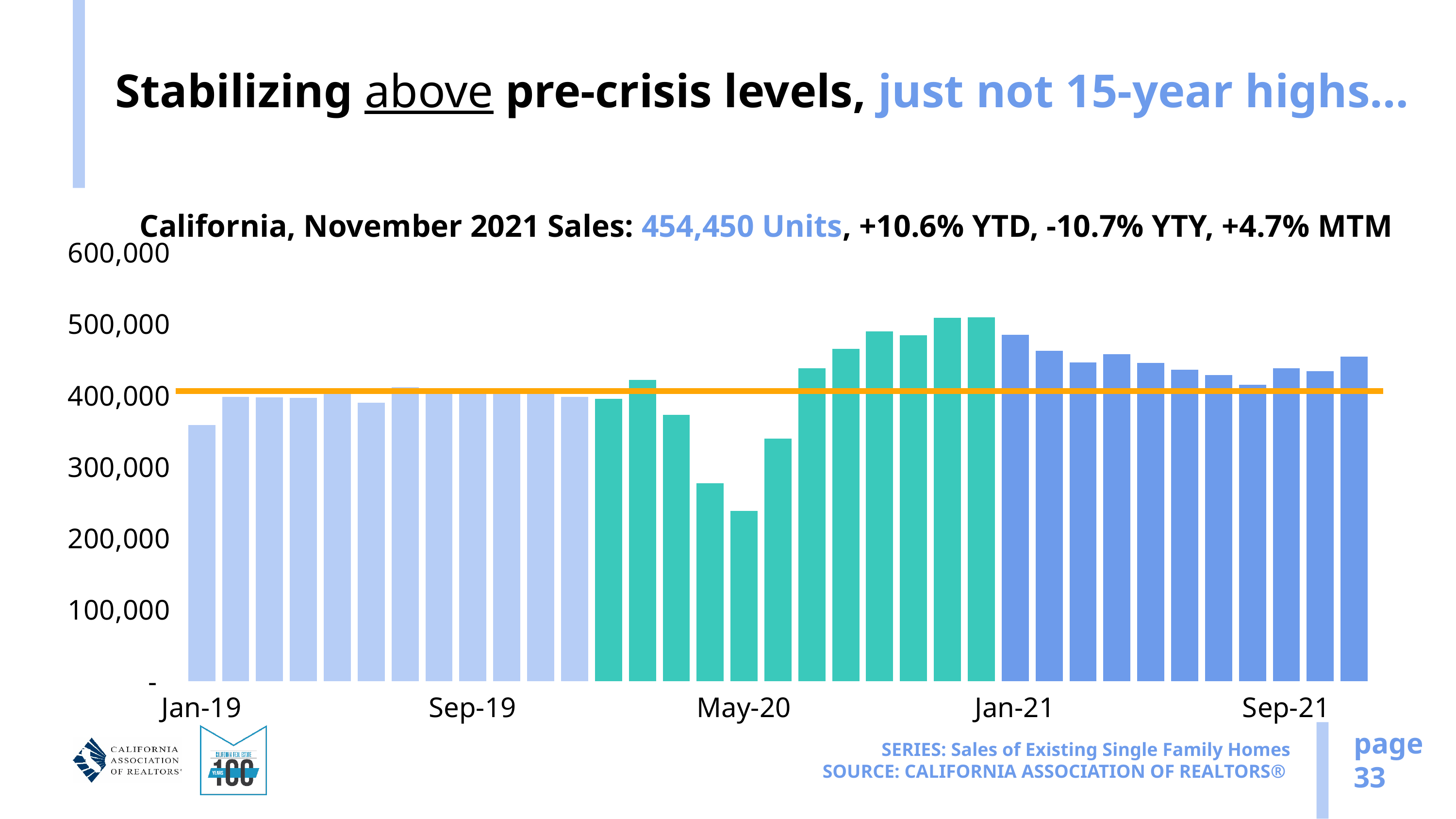
What is the year-to-date (YTD) change stated in the chart title? +10.6% Between May-20 and Jan-21, do the values generally rise or fall? rise Is the value for Jan-21 greater or less than 400,000? greater What kind of chart is shown on the slide? bar chart Which is larger, the value for Sep-19 or the value for Sep-21? Sep-21 How many bars are plotted on the chart? 35 Which month has the lowest bar on the chart? May-20 What is the California sales figure for November 2021 stated on the chart? 454,450 Units Is the value for May-20 greater or less than 300,000? less Is the value for Sep-21 greater or less than 500,000? less Which is larger, the value for Jan-19 or the value for Jan-21? Jan-21